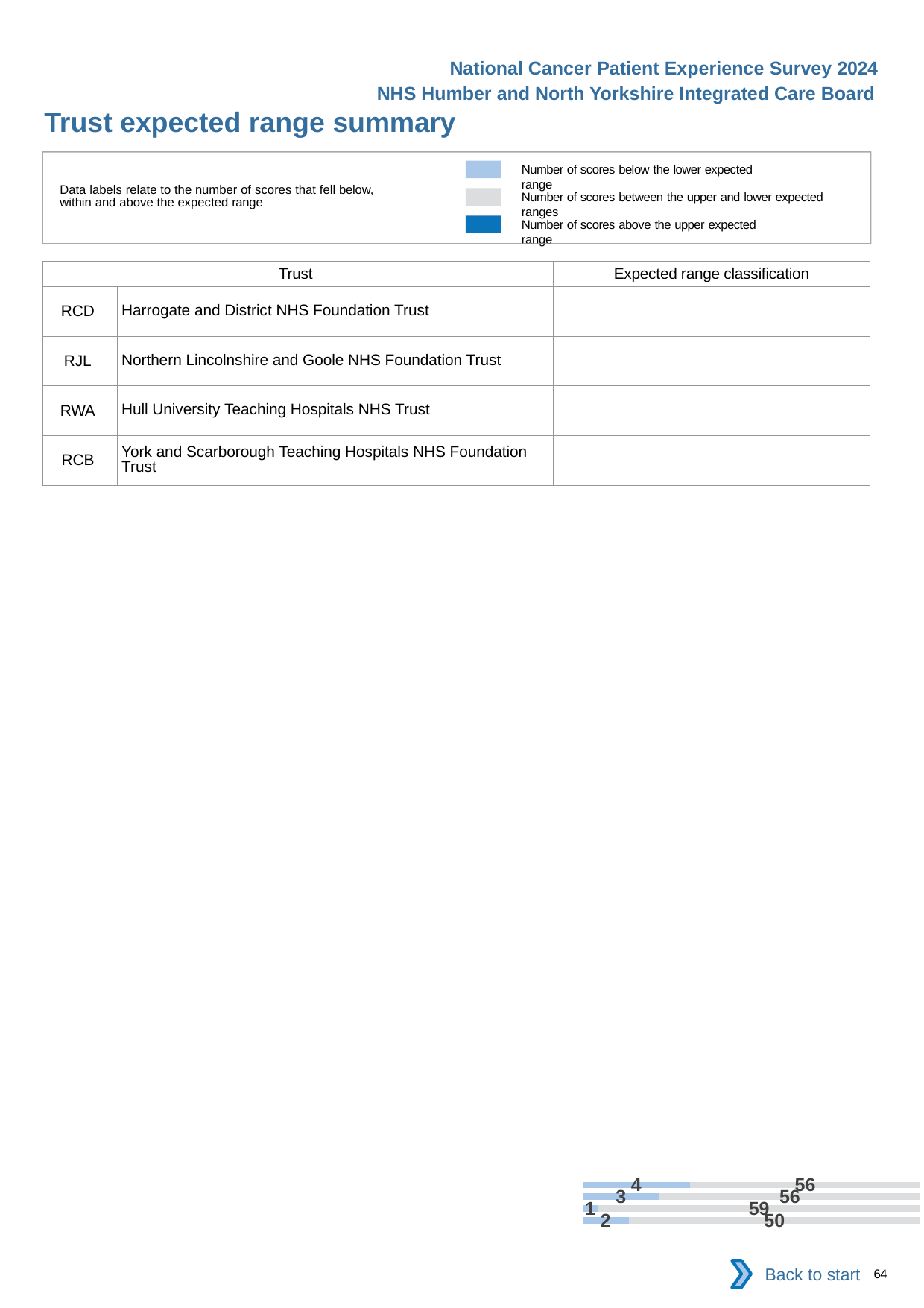
In the chart at the bottom of the slide, what is the total of the labelled values on the topmost bar? 60 In the chart at the bottom of the slide, which is larger: the light blue value on the topmost bar or the light blue value on the second bar from the top? topmost bar In the chart at the bottom of the slide, what is the grey (within expected range) value labelled on the bottom bar? 50 What kind of chart is shown at the bottom of the slide? bar chart How many bars does the chart at the bottom of the slide contain? 4 In the chart at the bottom of the slide, what is the grey (within expected range) value labelled on the third bar from the top? 59 In the chart at the bottom of the slide, what is the difference between the grey value on the topmost bar (56) and the grey value on the bottom bar (50)? 6 How many categories does the key at the top of the slide list for the chart? 3 In the chart at the bottom of the slide, what is the light blue (below lower expected range) value labelled on the topmost bar? 4 According to the key, which colour represents the number of scores above the upper expected range? dark blue In the chart at the bottom of the slide, which bar has the smallest light blue (below lower expected range) value? third bar from the top In the chart at the bottom of the slide, which bar has the largest grey (within expected range) value? third bar from the top